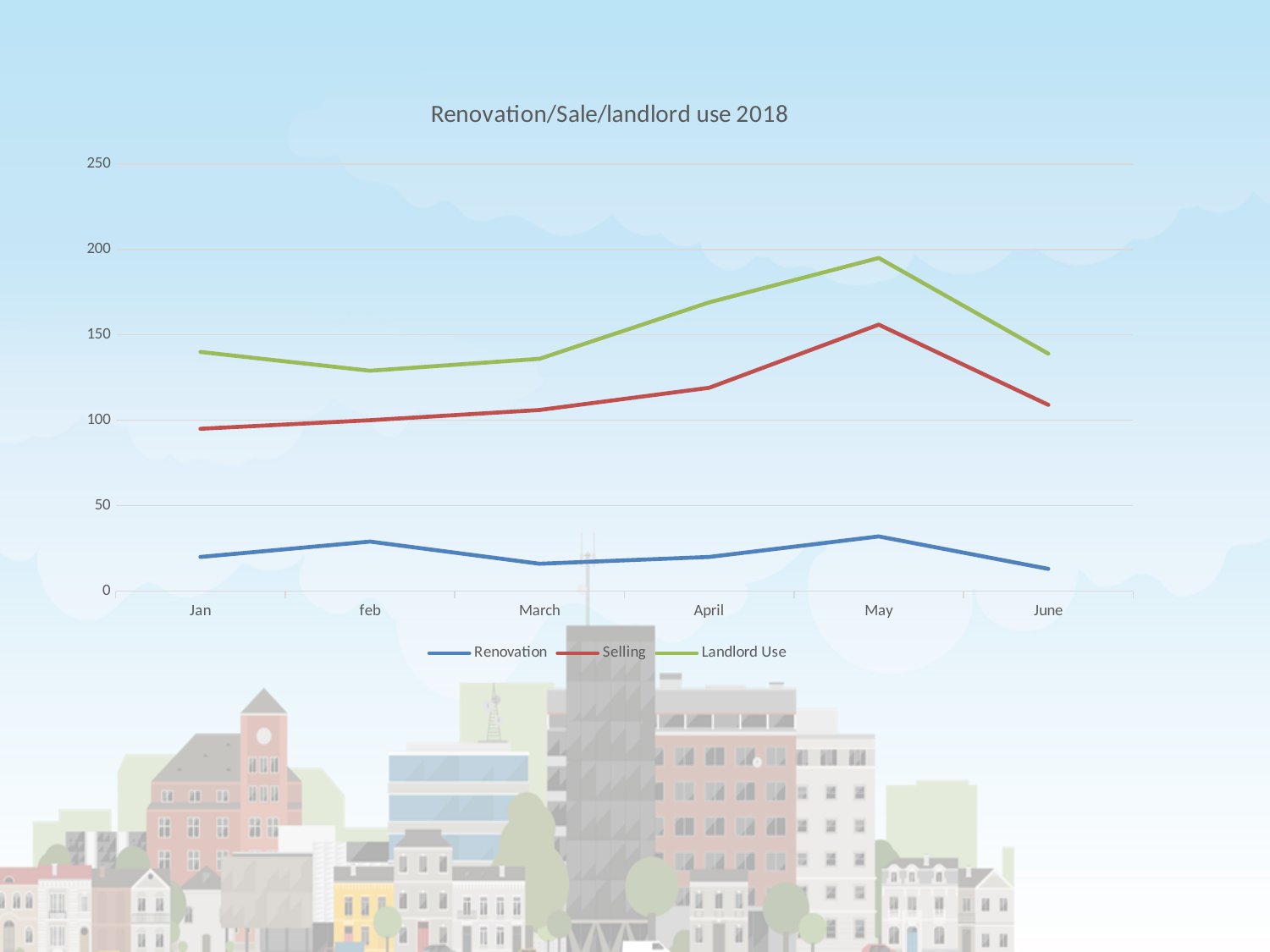
How many months are shown on the x axis? 6 Does the Selling series rise or fall from Jan to May? rise Is the value for Landlord Use in Jan greater or less than 100? greater What is the title of the chart? Renovation/Sale/landlord use 2018 What kind of chart is shown on the slide? line chart Is the value for Renovation in May greater or less than 50? less In May, which series has the larger value, Landlord Use or Selling? Landlord Use Is the value for Landlord Use in May greater or less than 150? greater How many series does the legend list? 3 In which month does the Landlord Use series reach its highest value? May In which month does the Selling series reach its highest value? May